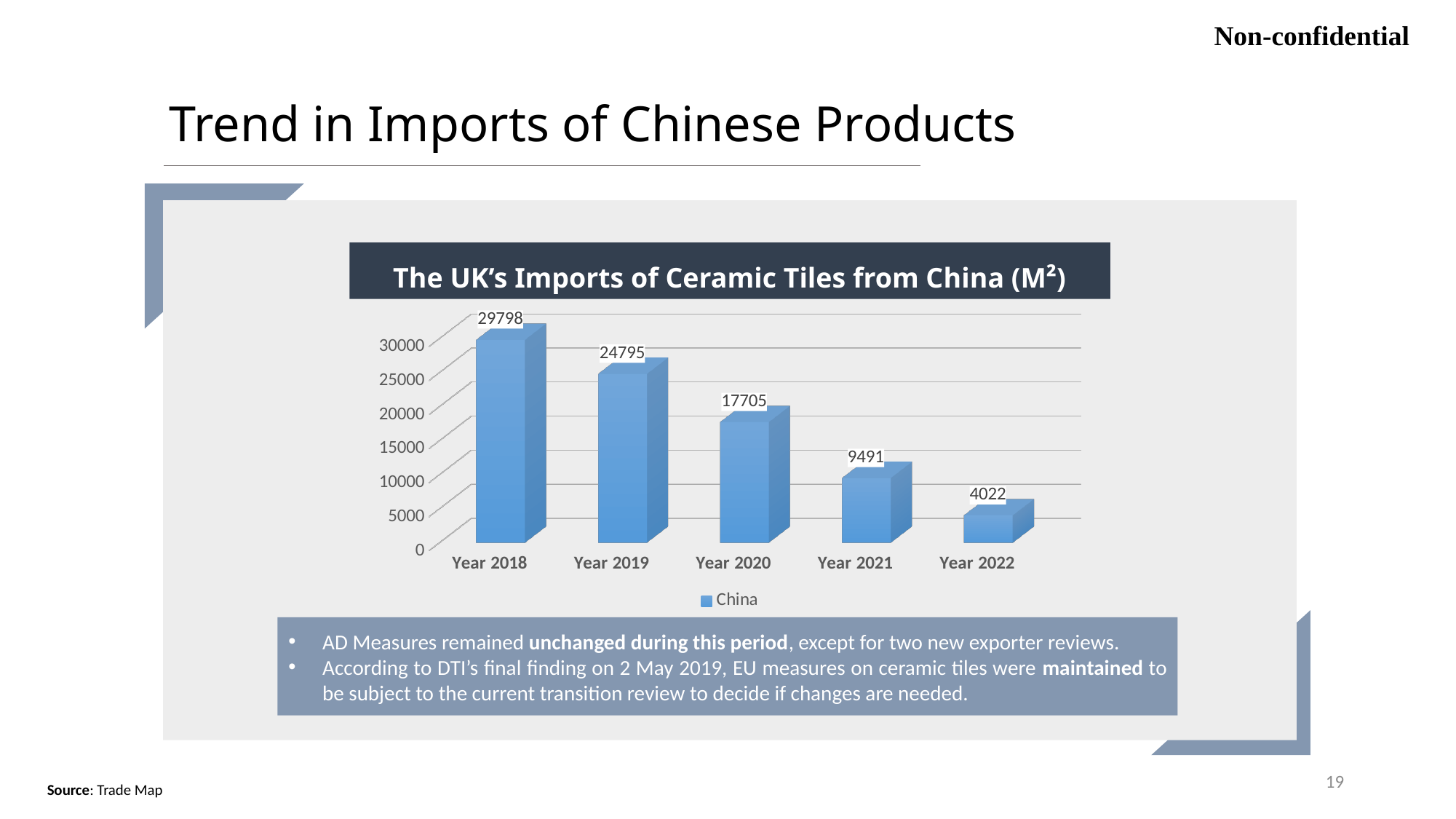
Which year has the highest value? Year 2018 How many years are shown on the x axis? 5 What is the value for Year 2022? 4022 What is the difference between the values for Year 2019 and Year 2021? 15304 What is the value for Year 2020? 17705 Which is larger, the value for Year 2020 or the value for Year 2021? Year 2020 Which year has the lowest value? Year 2022 Do the values rise or fall from Year 2018 to Year 2022? fall Is the value for Year 2019 greater or less than 20000? greater How many series does the legend list? 1 What kind of chart is shown? bar chart What is the value for Year 2018? 29798